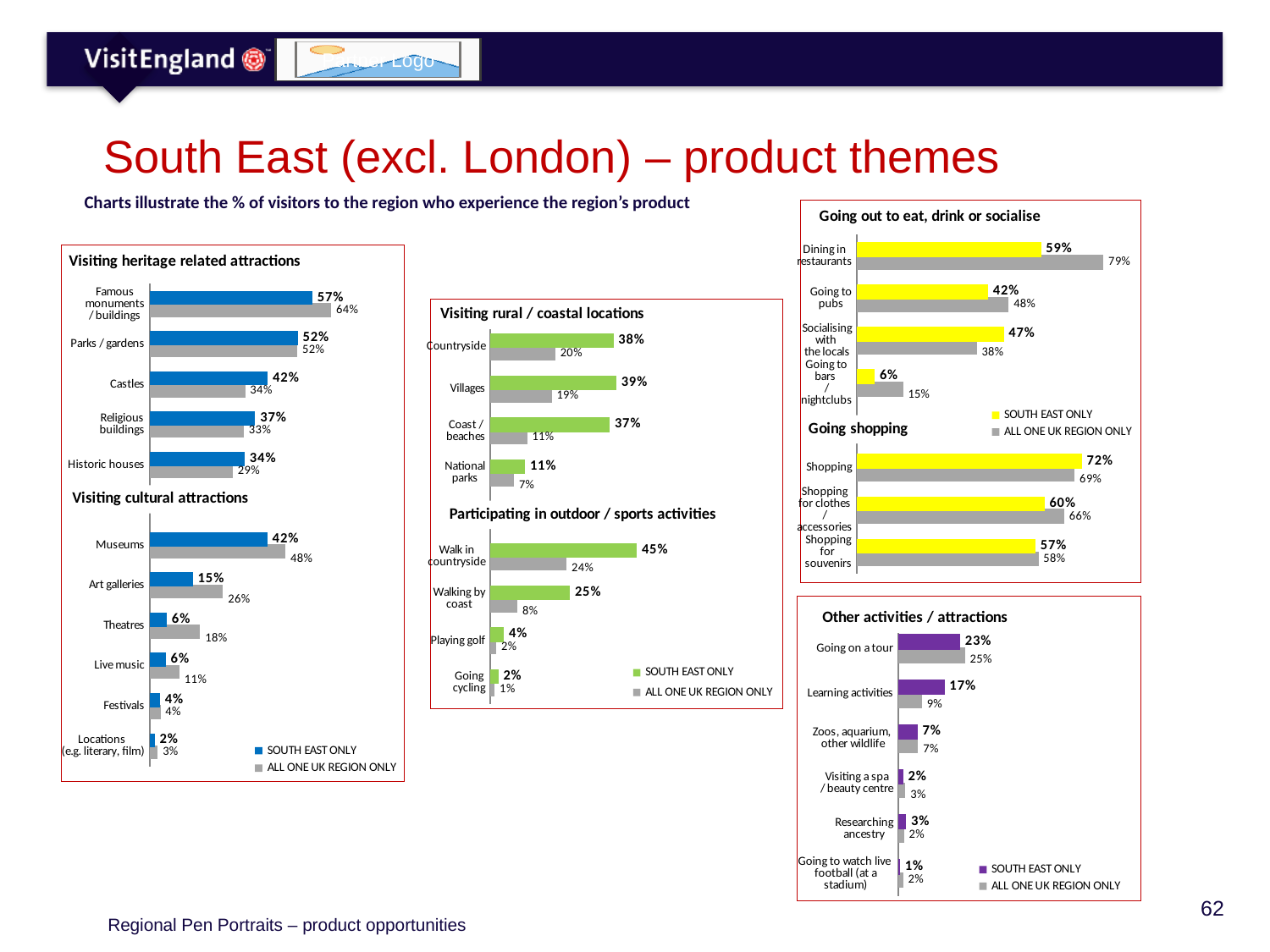
In the 'Visiting heritage related attractions' chart, what is the ALL ONE UK REGION ONLY value for Famous monuments / buildings? 64% In the 'Participating in outdoor / sports activities' chart, how many categories are shown? 4 In the 'Going out to eat, drink or socialise' chart, what is the SOUTH EAST ONLY value for Socialising with the locals? 47% How many series does the legend list in the 'Other activities / attractions' chart? 2 In the 'Going out to eat, drink or socialise' chart, which is larger for Dining in restaurants: SOUTH EAST ONLY or ALL ONE UK REGION ONLY? ALL ONE UK REGION ONLY In the 'Visiting cultural attractions' chart, which category has the highest SOUTH EAST ONLY value? Museums In the 'Visiting rural / coastal locations' chart, what is the SOUTH EAST ONLY value for Coast / beaches? 37% In the 'Visiting rural / coastal locations' chart, which category has the lowest ALL ONE UK REGION ONLY value? National parks In the 'Other activities / attractions' chart, what is the SOUTH EAST ONLY value for Learning activities? 17% In the 'Visiting cultural attractions' chart, what is the difference between the ALL ONE UK REGION ONLY and SOUTH EAST ONLY values for Art galleries? 11% In the 'Visiting heritage related attractions' chart, what is the SOUTH EAST ONLY value for Castles? 42% In the 'Going shopping' chart, what is the ALL ONE UK REGION ONLY value for Shopping for souvenirs? 58%